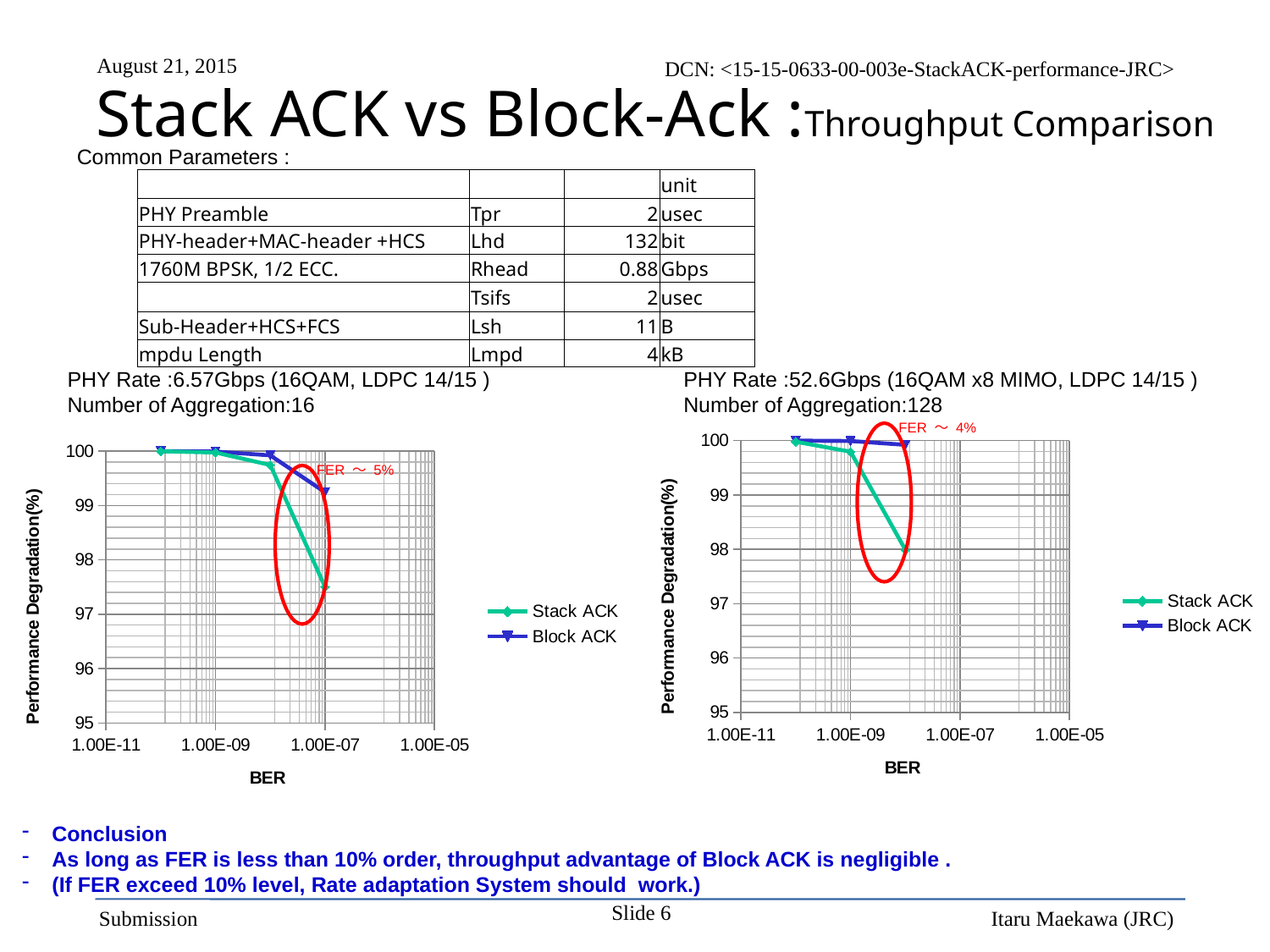
In the left chart (Number of Aggregation:16), does the Stack ACK line rise or fall as BER increases along the x axis? fall In the right chart (Number of Aggregation:128), which series has the higher value at BER 1.00E-08, Stack ACK or Block ACK? Block ACK What is the label of the y axis on the left chart (Number of Aggregation:16)? Performance Degradation(%) In the left chart (Number of Aggregation:16), is the Stack ACK value at BER 1.00E-07 greater or less than 97? greater In the right chart (Number of Aggregation:128), is the Block ACK value at BER 1.00E-08 greater or less than 99? greater In the left chart (Number of Aggregation:16), which series has the higher value at BER 1.00E-07, Stack ACK or Block ACK? Block ACK In the left chart (Number of Aggregation:16), is the Block ACK value at BER 1.00E-07 greater or less than 99? greater What are the two series named in the legend of the right chart (Number of Aggregation:128)? Stack ACK and Block ACK How many data points are plotted for the Stack ACK series in the right chart (Number of Aggregation:128)? 3 How many series does the legend of the left chart (Number of Aggregation:16) list? 2 What kind of chart is the left chart (PHY Rate 6.57Gbps, Number of Aggregation:16)? line chart